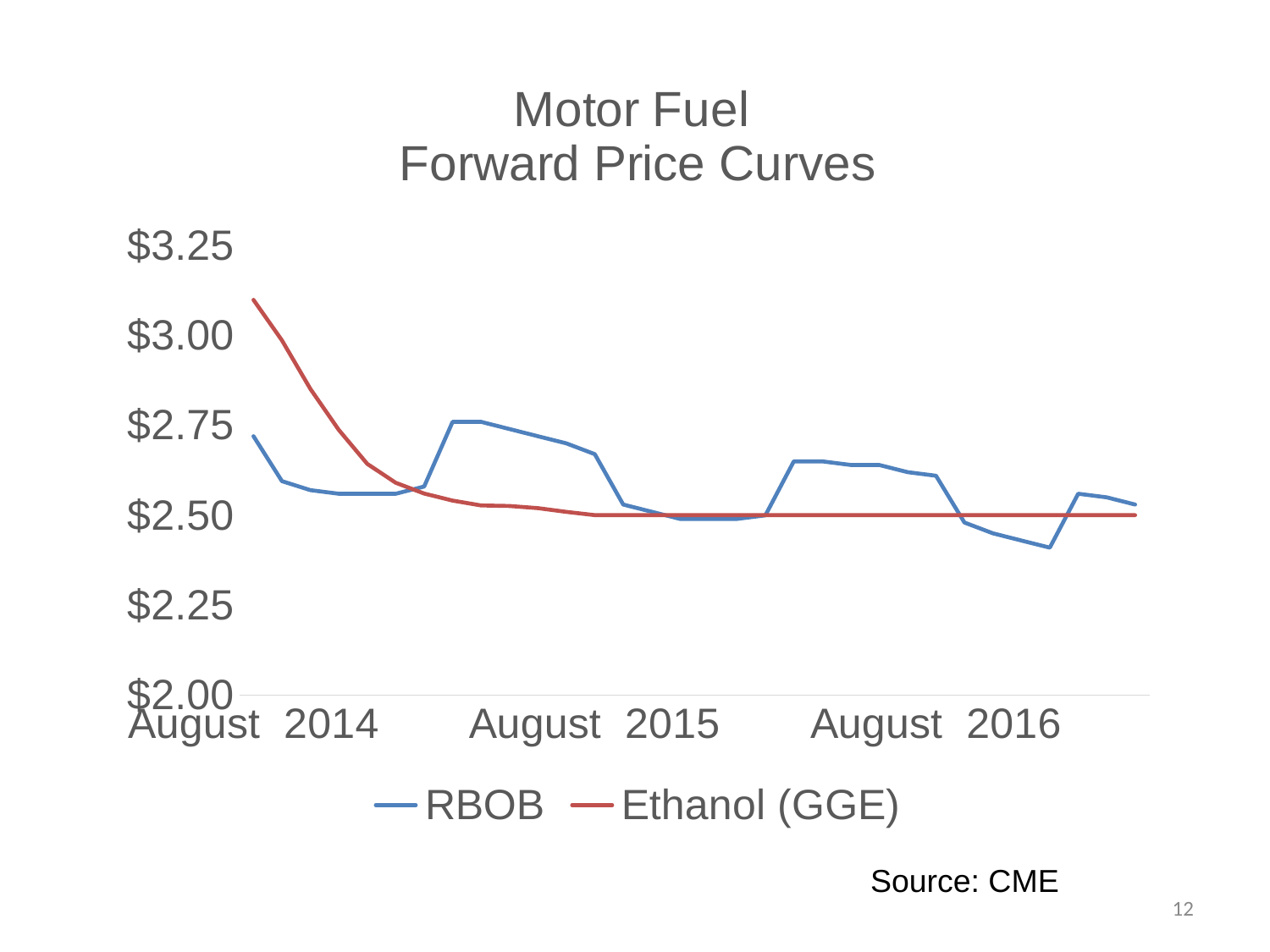
Is the RBOB value at August 2014 greater or less than $2.50? greater Which series reaches the lowest price on the chart? RBOB Is the Ethanol (GGE) value at August 2014 greater or less than $3.00? greater What source is cited for the chart? CME Is the lowest RBOB value on the chart greater or less than $2.50? less At August 2014, which series has the higher price, RBOB or Ethanol (GGE)? Ethanol (GGE) Which series reaches the highest price on the chart? Ethanol (GGE) How many date labels are shown on the x axis? 3 What kind of chart is shown on the slide? line chart How many series does the legend list? 2 What is the title of the chart? Motor Fuel Forward Price Curves Does the Ethanol (GGE) line rise or fall from August 2014 to August 2015? fall